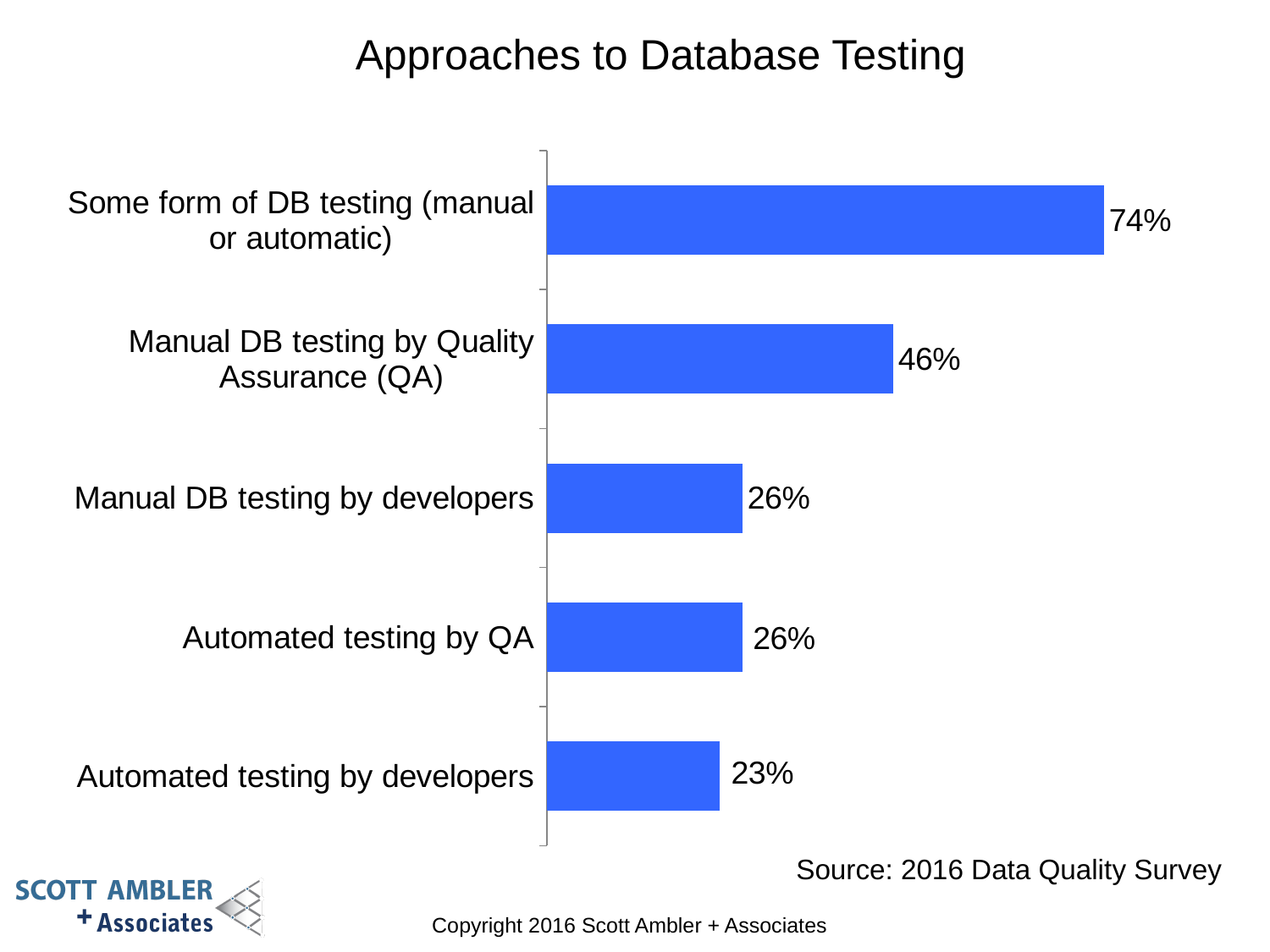
Which category has the lowest value? Automated testing by developers What is the difference between 'Some form of DB testing (manual or automatic)' and 'Manual DB testing by Quality Assurance (QA)'? 28% What kind of chart is shown on the slide? Bar chart Which category has the highest value? Some form of DB testing (manual or automatic) What is the difference between 'Automated testing by QA' and 'Automated testing by developers'? 3% What is the value for 'Manual DB testing by Quality Assurance (QA)'? 46% Which is larger: 'Manual DB testing by Quality Assurance (QA)' or 'Manual DB testing by developers'? Manual DB testing by Quality Assurance (QA) What is the value for 'Automated testing by developers'? 23% What percentage is shown for 'Some form of DB testing (manual or automatic)'? 74% What is the title of the chart? Approaches to Database Testing What is the value for 'Manual DB testing by developers'? 26% How many categories are shown in the chart? 5